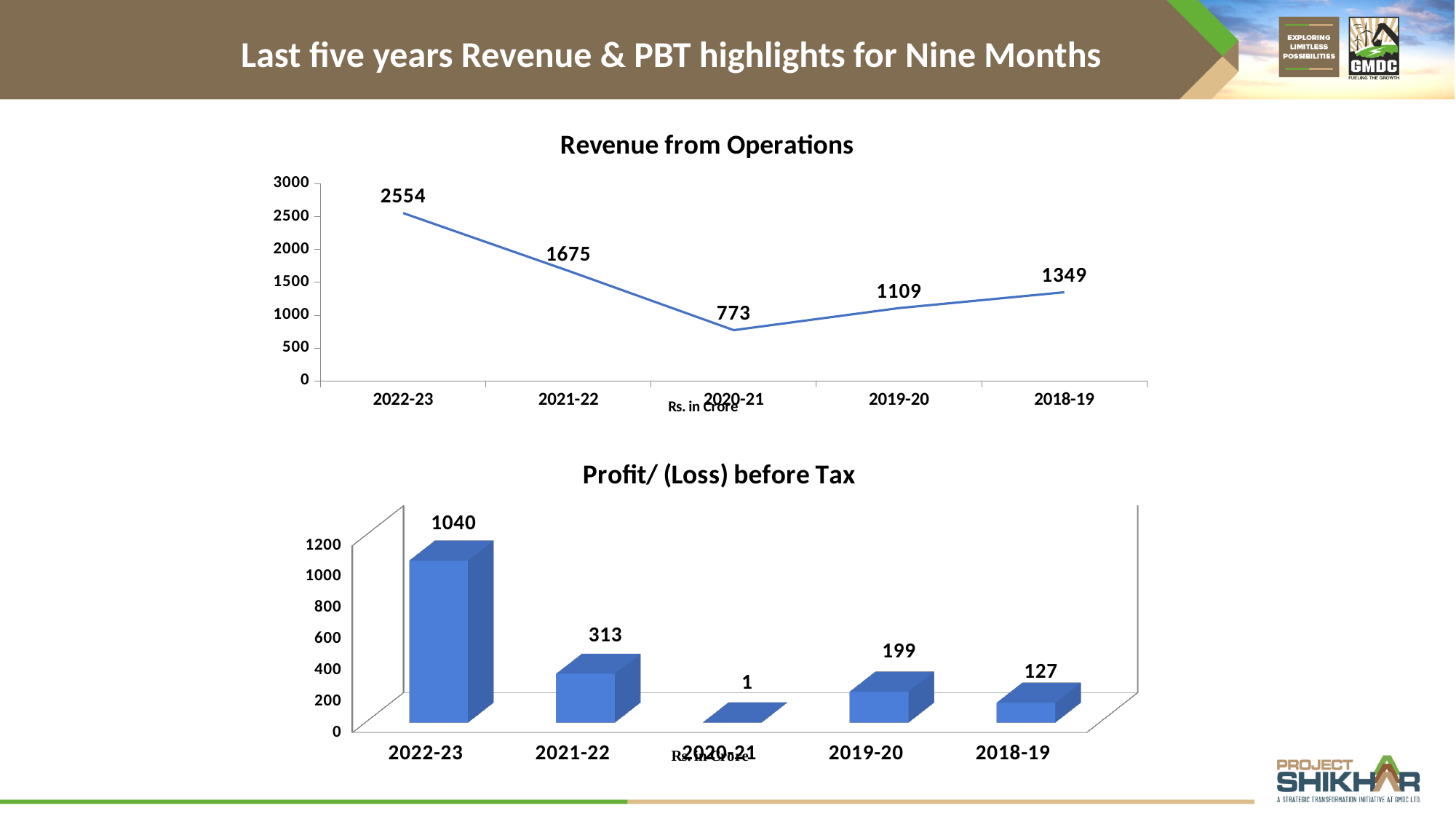
In the 'Revenue from Operations' chart, what is the value for 2020-21? 773 In the 'Profit/ (Loss) before Tax' chart, which year has the highest value? 2022-23 In the 'Profit/ (Loss) before Tax' chart, what is the difference between the values for 2019-20 and 2018-19? 72 In the 'Revenue from Operations' chart, which year has the lowest revenue? 2020-21 In the 'Profit/ (Loss) before Tax' chart, what is the value for 2021-22? 313 In the 'Revenue from Operations' chart, what is the value for 2022-23? 2554 How many data points are plotted in the 'Revenue from Operations' chart? 5 What kind of chart is the 'Profit/ (Loss) before Tax' chart? Bar chart In the 'Profit/ (Loss) before Tax' chart, is the value for 2022-23 greater or less than 1000? greater In the 'Revenue from Operations' chart, which is larger, the value for 2019-20 or 2018-19? 2018-19 In the 'Revenue from Operations' chart, what is the difference between the values for 2022-23 and 2021-22? 879 What kind of chart is the 'Revenue from Operations' chart? Line chart